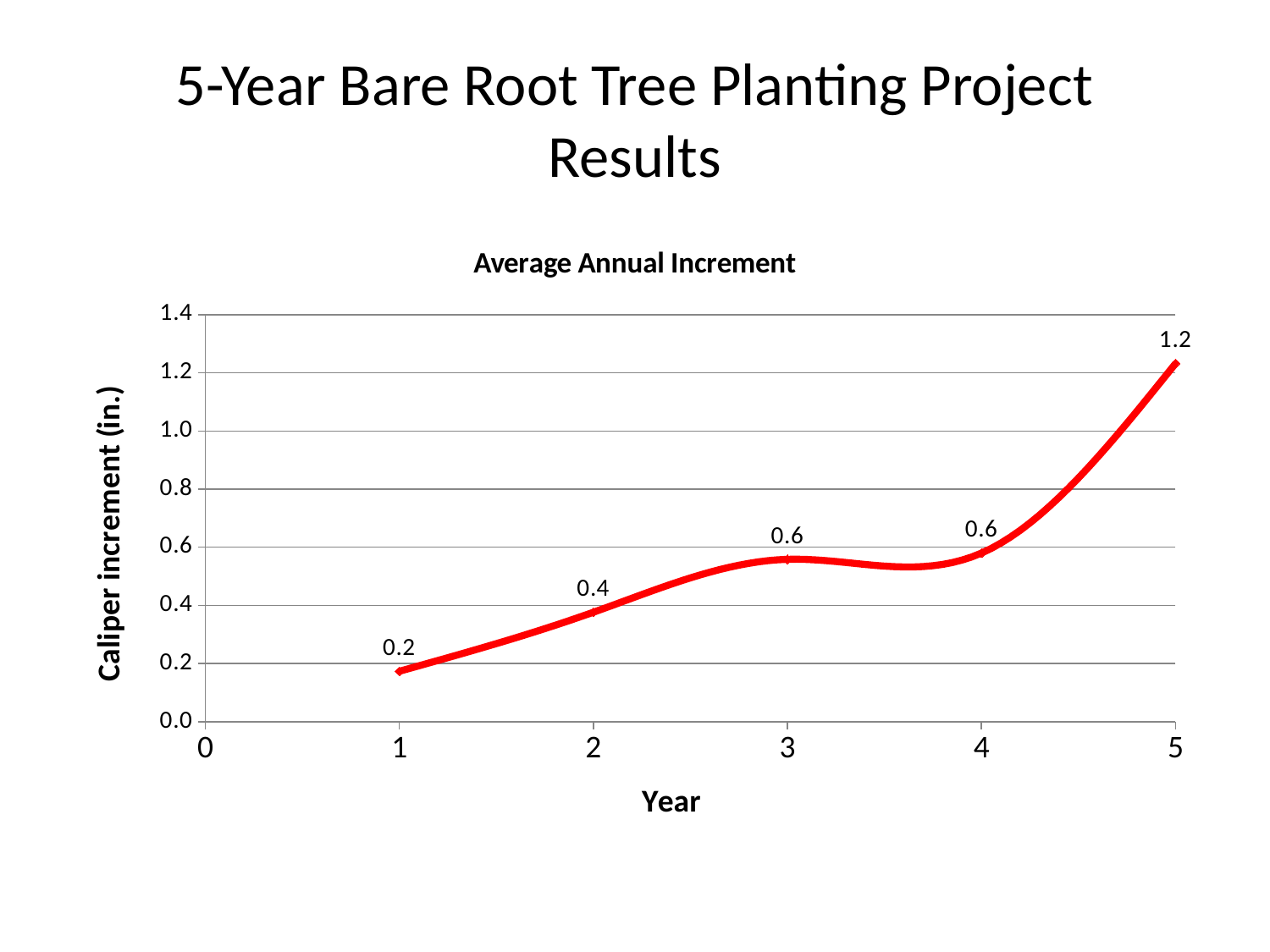
Which year has the highest caliper increment? Year 5 What is the caliper increment value labelled for year 5? 1.2 What is the caliper increment value labelled for year 1? 0.2 Which has the larger caliper increment, year 2 or year 5? Year 5 What is the difference between the labelled caliper increment for year 5 and year 1? 1.0 How many data points are plotted on the chart? 5 Is the value for year 4 greater or less than 0.8? less Which year has the lowest caliper increment? Year 1 Do the caliper increment values generally rise or fall from year 1 to year 5? Rise What is the caliper increment value labelled for year 2? 0.4 What kind of chart is shown on the slide? Line chart What is the title of the chart? Average Annual Increment